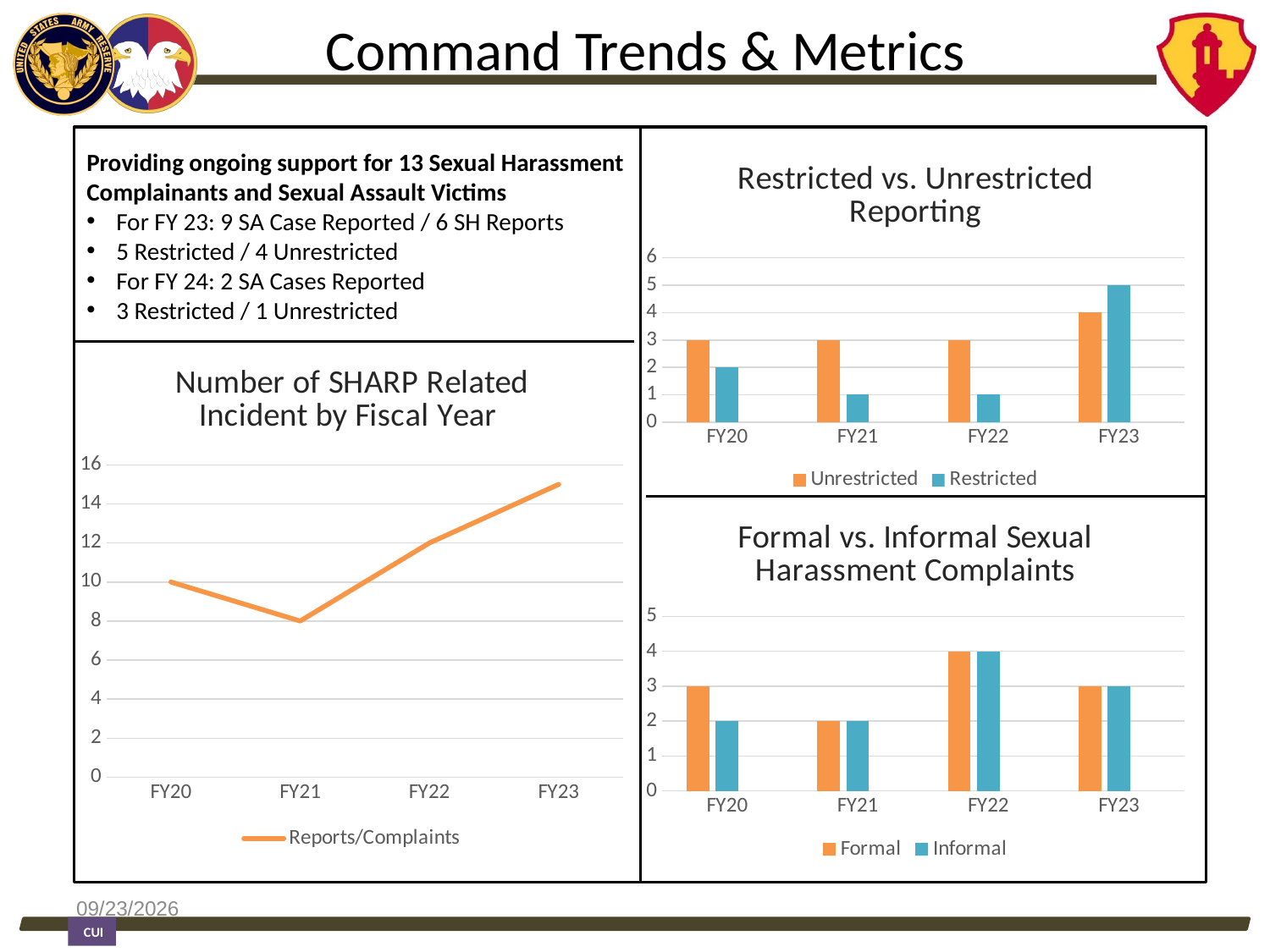
In the 'Restricted vs. Unrestricted Reporting' chart, what is the Restricted value for FY23? 5 In the 'Restricted vs. Unrestricted Reporting' chart, which is larger for FY20, Unrestricted or Restricted? Unrestricted In the 'Formal vs. Informal Sexual Harassment Complaints' chart, how many fiscal years are shown on the x axis? 4 In the 'Number of SHARP Related Incident by Fiscal Year' chart, is the value for FY23 greater or less than 14? greater In the 'Number of SHARP Related Incident by Fiscal Year' chart, what is the difference between the FY22 and FY20 values? 2 In the 'Number of SHARP Related Incident by Fiscal Year' chart, what type of chart is shown? line chart In the 'Formal vs. Informal Sexual Harassment Complaints' chart, what is the Formal value for FY22? 4 In the 'Restricted vs. Unrestricted Reporting' chart, which fiscal year has the highest Restricted value? FY23 In the 'Restricted vs. Unrestricted Reporting' chart, how many series does the legend list? 2 In the 'Formal vs. Informal Sexual Harassment Complaints' chart, what is the difference between the Formal and Informal values for FY20? 1 In the 'Number of SHARP Related Incident by Fiscal Year' chart, what is the value for FY21? 8 In the 'Number of SHARP Related Incident by Fiscal Year' chart, which fiscal year has the lowest value? FY21